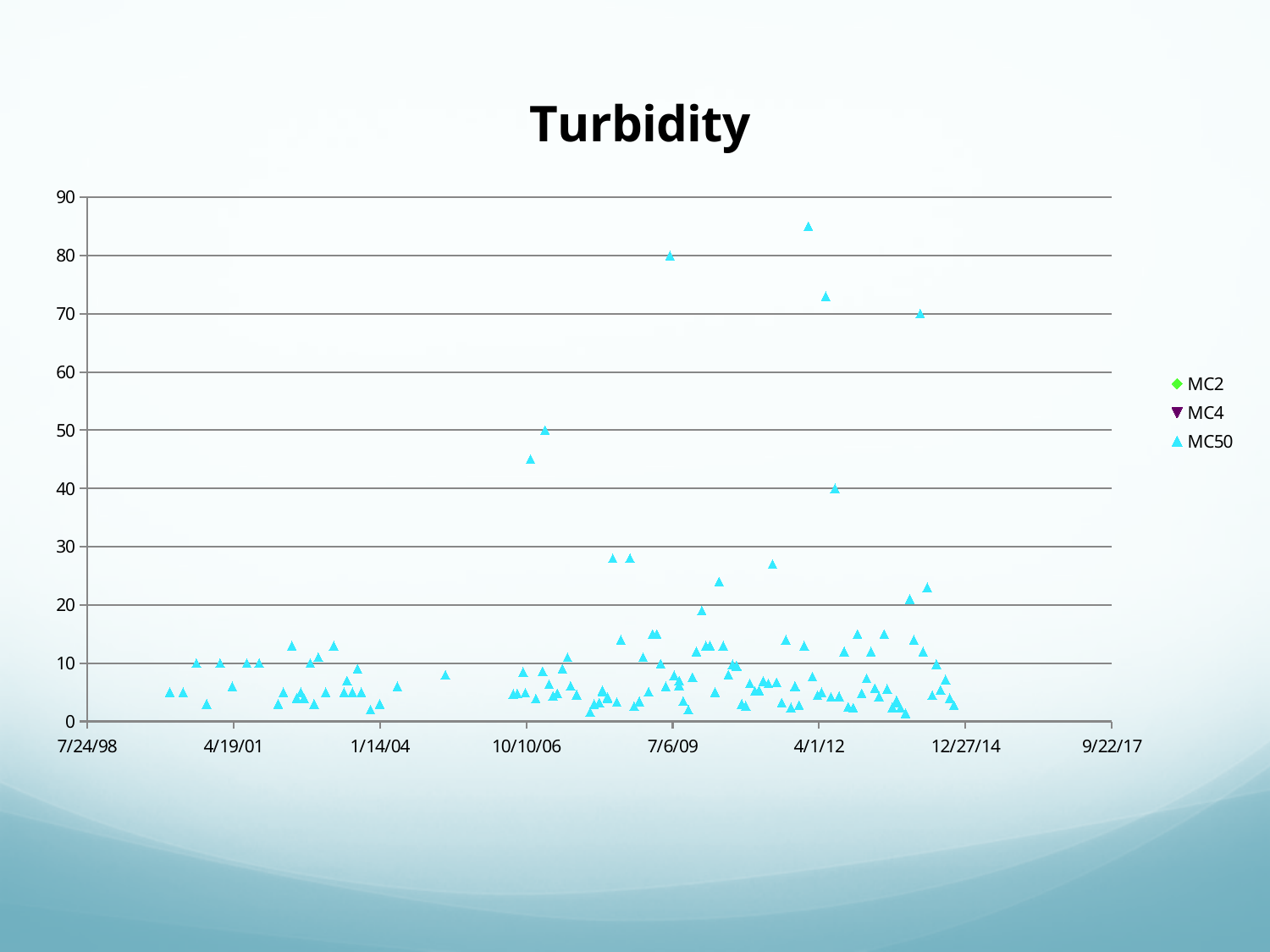
Which series has visible data points plotted on the chart? MC50 What is the highest value shown on the y axis? 90 What is the last date label shown on the x axis? 9/22/17 What kind of chart is shown on the slide? scatter chart What is the first date label shown on the x axis? 7/24/98 Which series are listed in the chart legend? MC2, MC4, MC50 Is the highest point plotted near 10/10/06 greater or less than 40? greater Is the highest plotted point on the chart greater or less than 90? less How many series does the legend list? 3 Is the highest plotted point on the chart greater or less than 80? greater What is the title of the chart? Turbidity